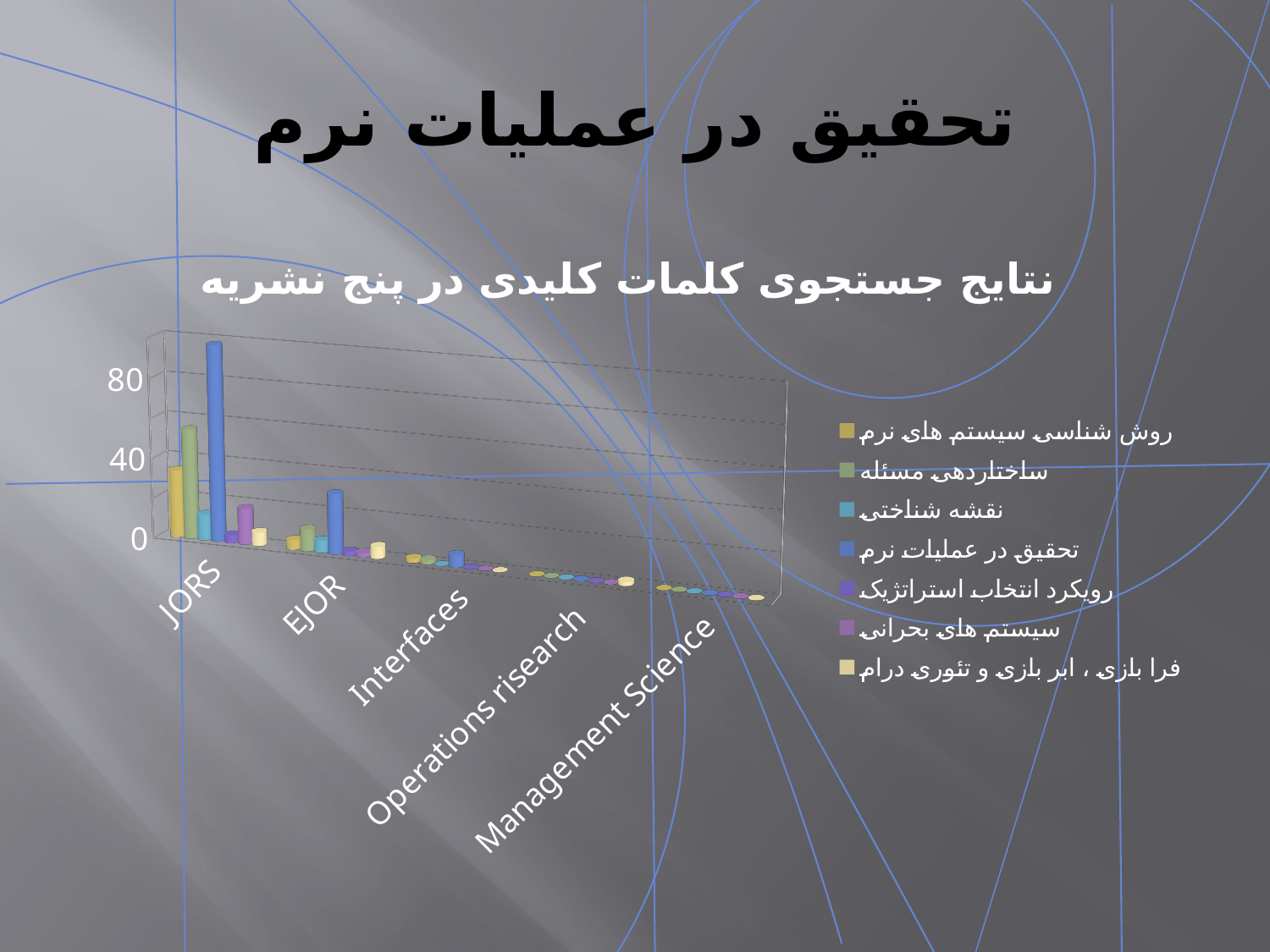
Is the value of تحقیق در عملیات نرم for EJOR greater or less than 40? less Do the bar heights generally rise or fall moving from JORS to Management Science along the x axis? Fall What kind of chart is shown on the slide? Bar chart How many journals (categories) are shown on the x axis of the chart? 5 Which journal has the tallest bar in the chart? JORS Is the value of تحقیق در عملیات نرم for JORS greater or less than 80? greater Which series has the tallest bar for JORS? تحقیق در عملیات نرم What is the title of the chart? نتایج جستجوی کلمات کلیدی در پنج نشریه How many series does the chart's legend list? 7 Is the value of ساختاردهی مسئله for JORS greater or less than 40? greater Which journal has the lowest values overall in the chart? Management Science Which is larger: the value of تحقیق در عملیات نرم for JORS or for EJOR? JORS